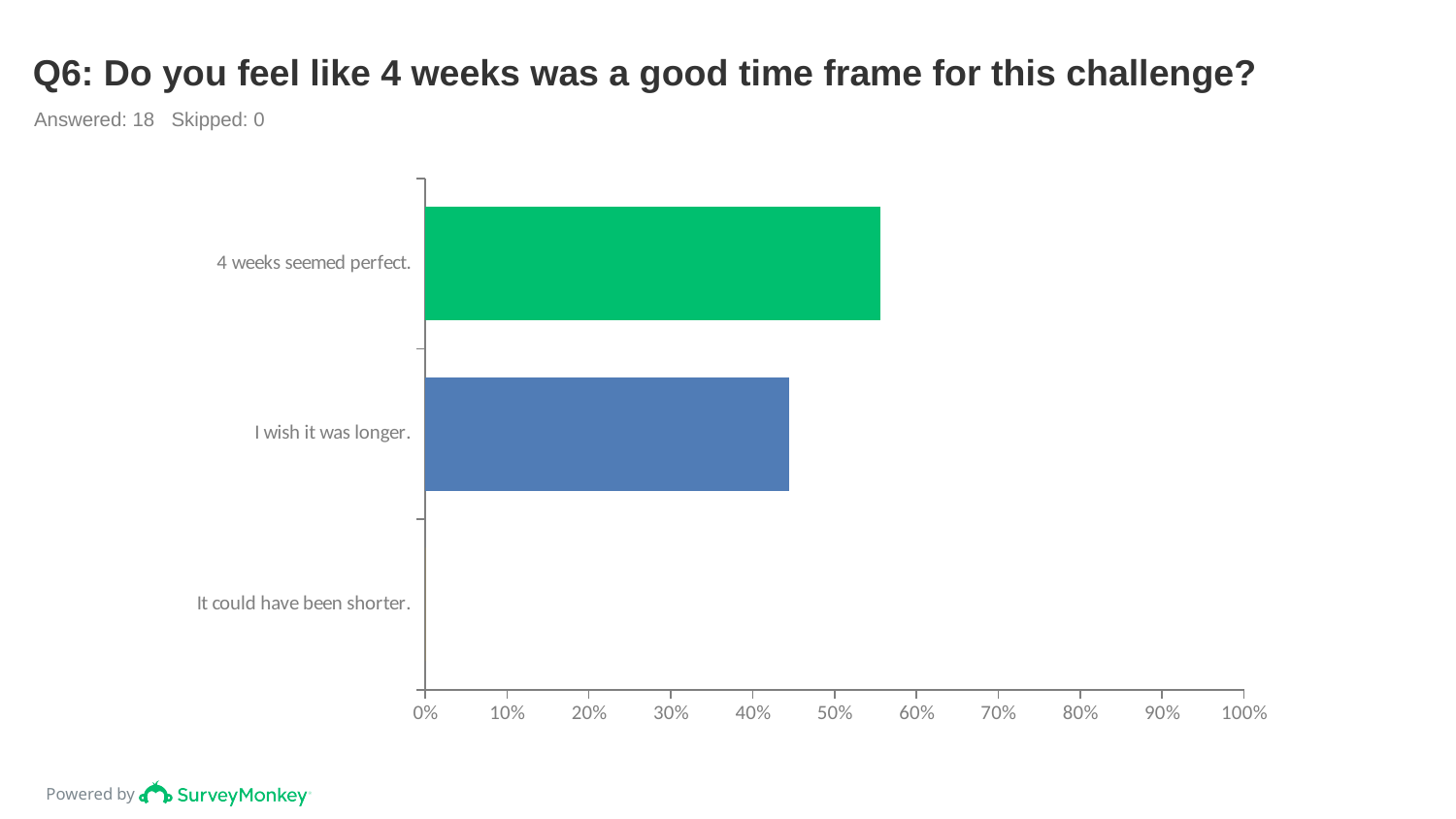
How many respondents answered the question according to the slide? 18 What kind of chart is shown on the slide? bar chart Is the value for "I wish it was longer." greater or less than 50%? less Which is larger: the value for "4 weeks seemed perfect." or the value for "I wish it was longer."? 4 weeks seemed perfect. Is the value for "4 weeks seemed perfect." greater or less than 50%? greater Which response category has the lowest value? It could have been shorter. How many response categories are shown in the chart? 3 Is the value for "I wish it was longer." greater or less than 40%? greater Which response category has the highest value? 4 weeks seemed perfect. What is the value for "It could have been shorter."? 0% What is the title of the chart? Q6: Do you feel like 4 weeks was a good time frame for this challenge?